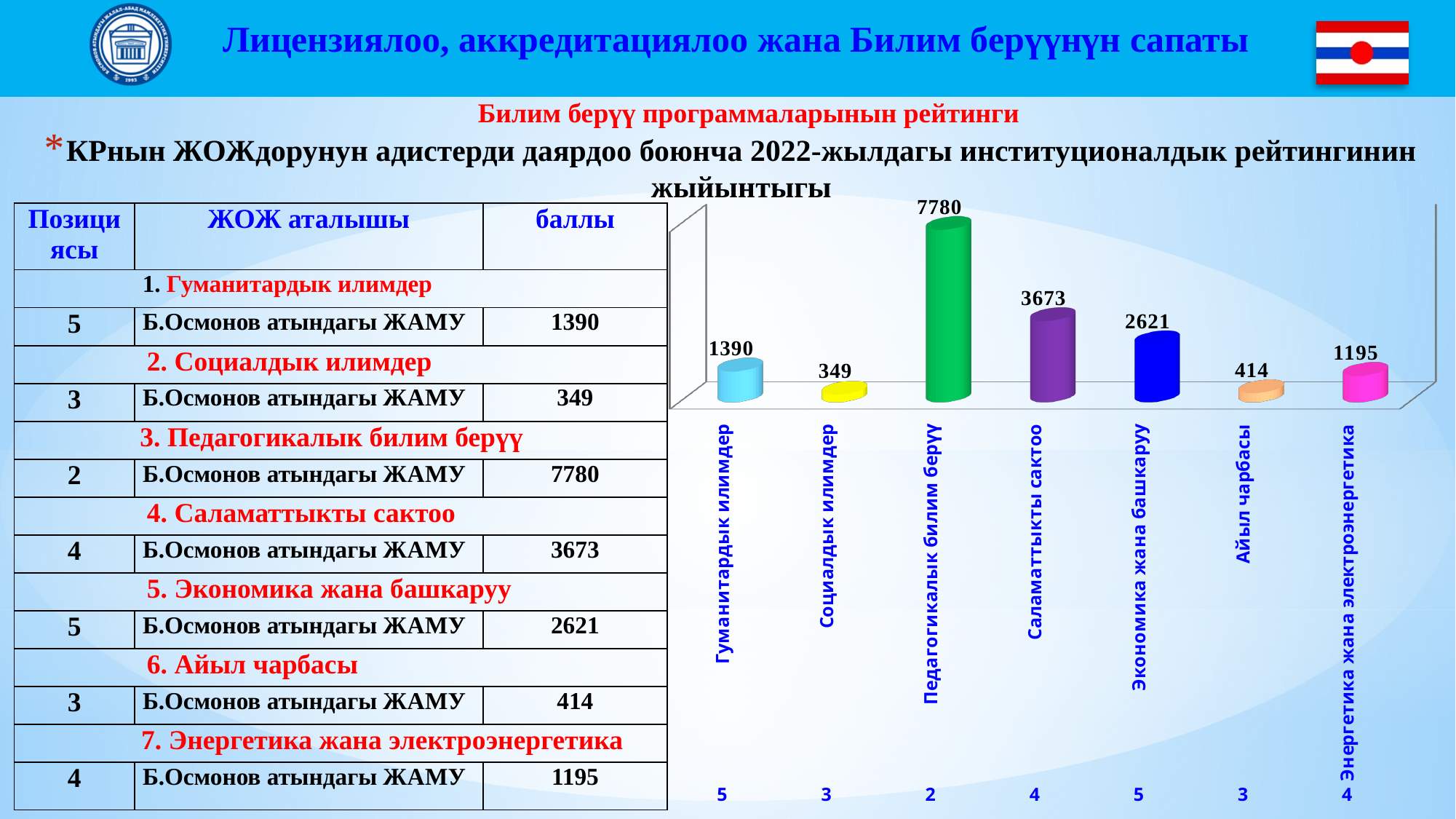
What value is shown for Педагогикалык билим берүү in the chart? 7780 What value is shown for Экономика жана башкаруу in the chart? 2621 What value is shown for Социалдык илимдер in the chart? 349 What value is shown for Энергетика жана электроэнергетика in the chart? 1195 Which is larger: the value for Саламаттыкты сактоо or the value for Экономика жана башкаруу? Саламаттыкты сактоо Which category has the highest value in the chart? Педагогикалык билим берүү What is the difference between the values for Педагогикалык билим берүү and Саламаттыкты сактоо? 4107 What colour is the bar for Педагогикалык билим берүү? green What kind of chart is shown on the slide? bar chart What is the difference between the values for Гуманитардык илимдер and Айыл чарбасы? 976 Which category has the lowest value in the chart? Социалдык илимдер How many categories are plotted in the chart? 7